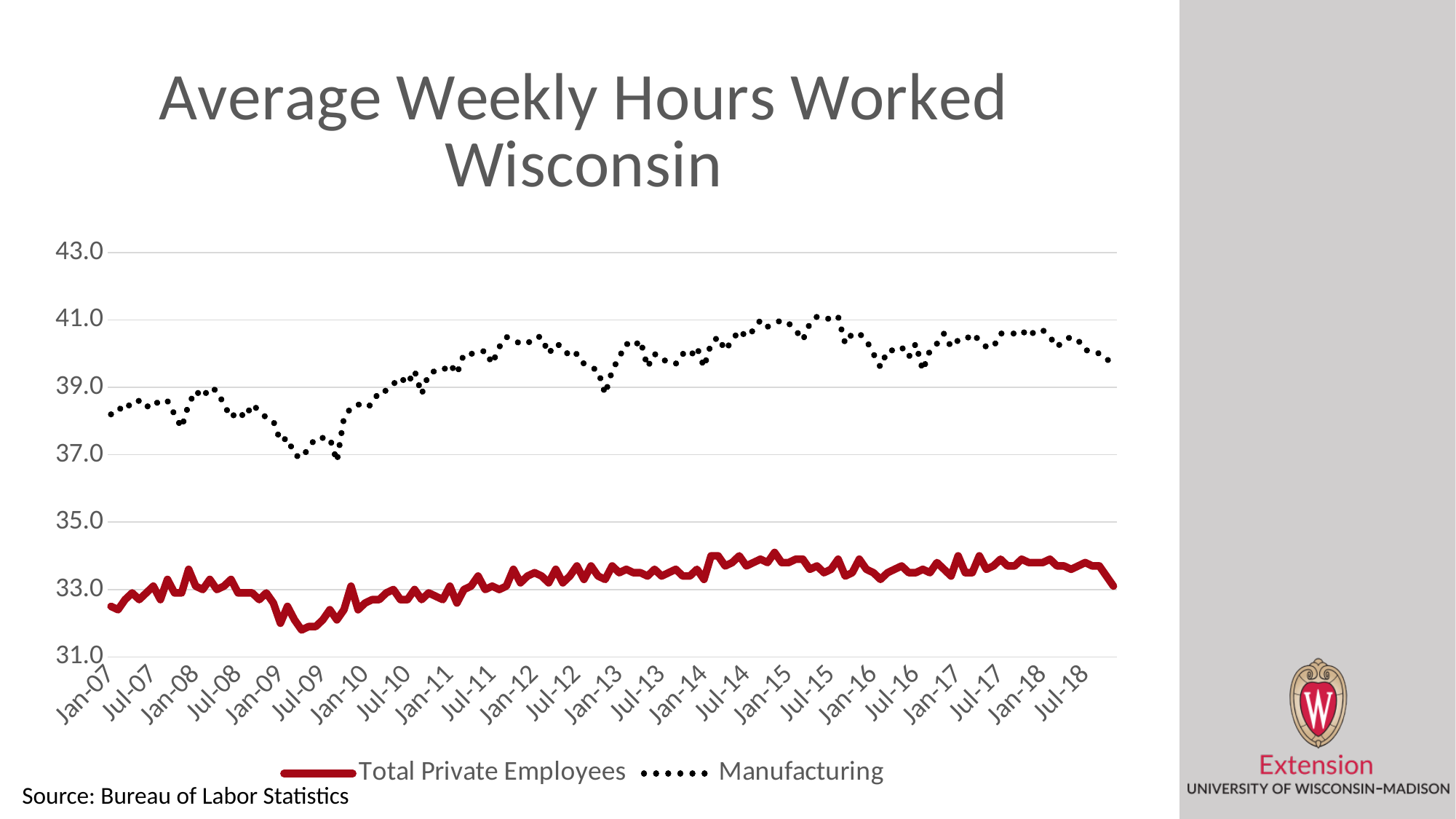
Which series is drawn as a dotted line? Manufacturing Does the Total Private Employees series rise or fall between Jul-09 and Jan-12? rise Is the value for Manufacturing at Jan-07 greater or less than 39.0? less Is the value for Total Private Employees at Jul-09 greater or less than 33.0? less What kind of chart is shown on the slide? line chart Is the value for Total Private Employees at Jan-15 greater or less than 35.0? less What is the title of the chart? Average Weekly Hours Worked Wisconsin At Jan-14, which series has the higher value, Total Private Employees or Manufacturing? Manufacturing How many series does the legend list? 2 Does the Manufacturing series rise or fall between Jan-08 and Jul-09? fall